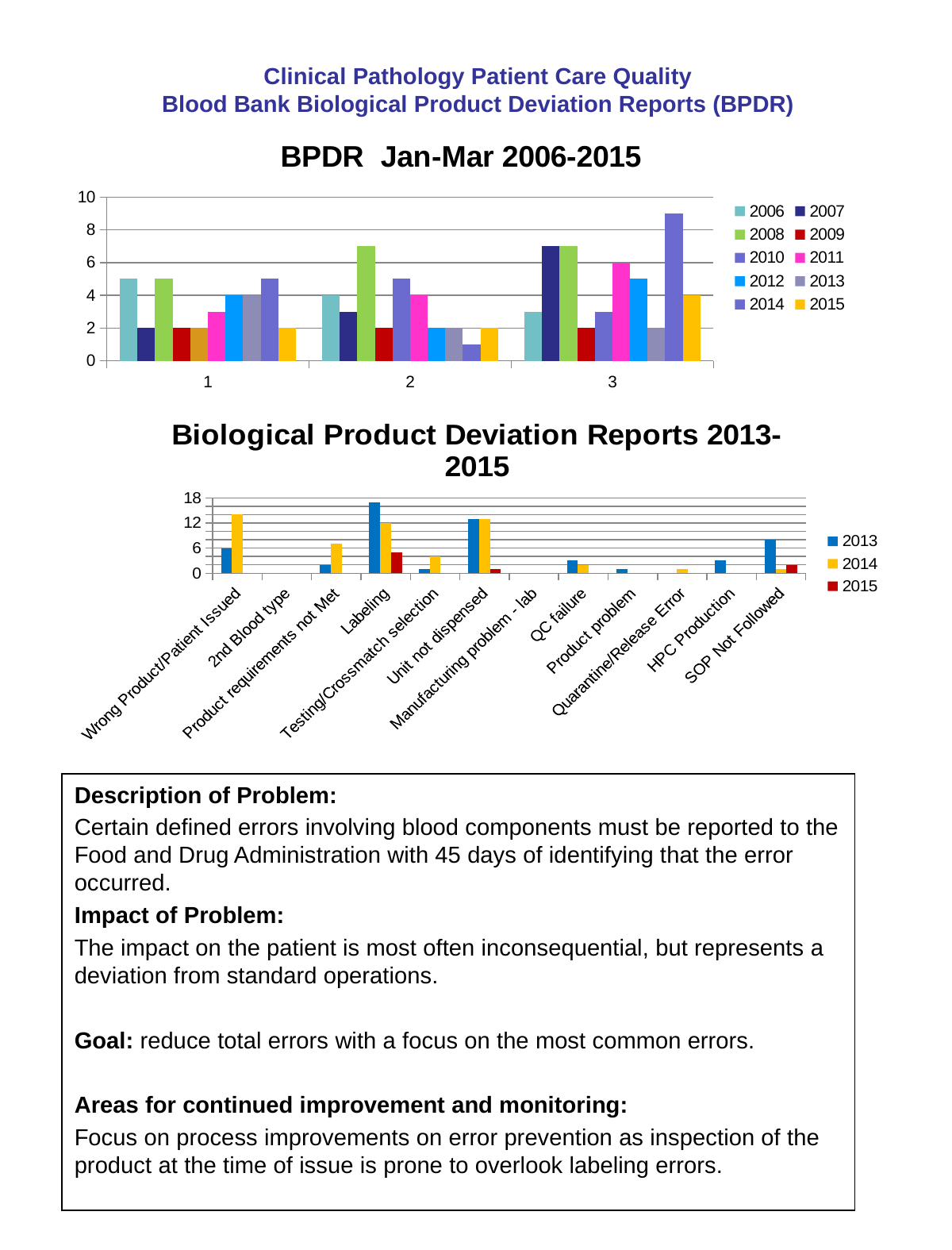
In the top chart 'BPDR Jan-Mar 2006-2015', what is the value for 2006 in category 2? 4 In the bottom chart 'Biological Product Deviation Reports 2013-2015', how many series does the legend list? 3 In the top chart 'BPDR Jan-Mar 2006-2015', is the value for 2014 in category 3 greater or less than 8? greater In the top chart 'BPDR Jan-Mar 2006-2015', how many series does the legend list? 10 In the top chart 'BPDR Jan-Mar 2006-2015', which year has the highest value in category 2? 2008 In the top chart 'BPDR Jan-Mar 2006-2015', which year has the highest value in category 3? 2014 In the top chart 'BPDR Jan-Mar 2006-2015', which is larger in category 3: the value for 2008 or the value for 2006? 2008 In the top chart 'BPDR Jan-Mar 2006-2015', how many categories are shown on the x axis? 3 In the top chart titled 'BPDR Jan-Mar 2006-2015', what kind of chart is shown? bar chart In the bottom chart 'Biological Product Deviation Reports 2013-2015', is the 2013 value for Labeling greater or less than 12? greater In the bottom chart 'Biological Product Deviation Reports 2013-2015', which category has the highest value for 2013? Labeling In the bottom chart 'Biological Product Deviation Reports 2013-2015', how many categories are shown on the x axis? 12